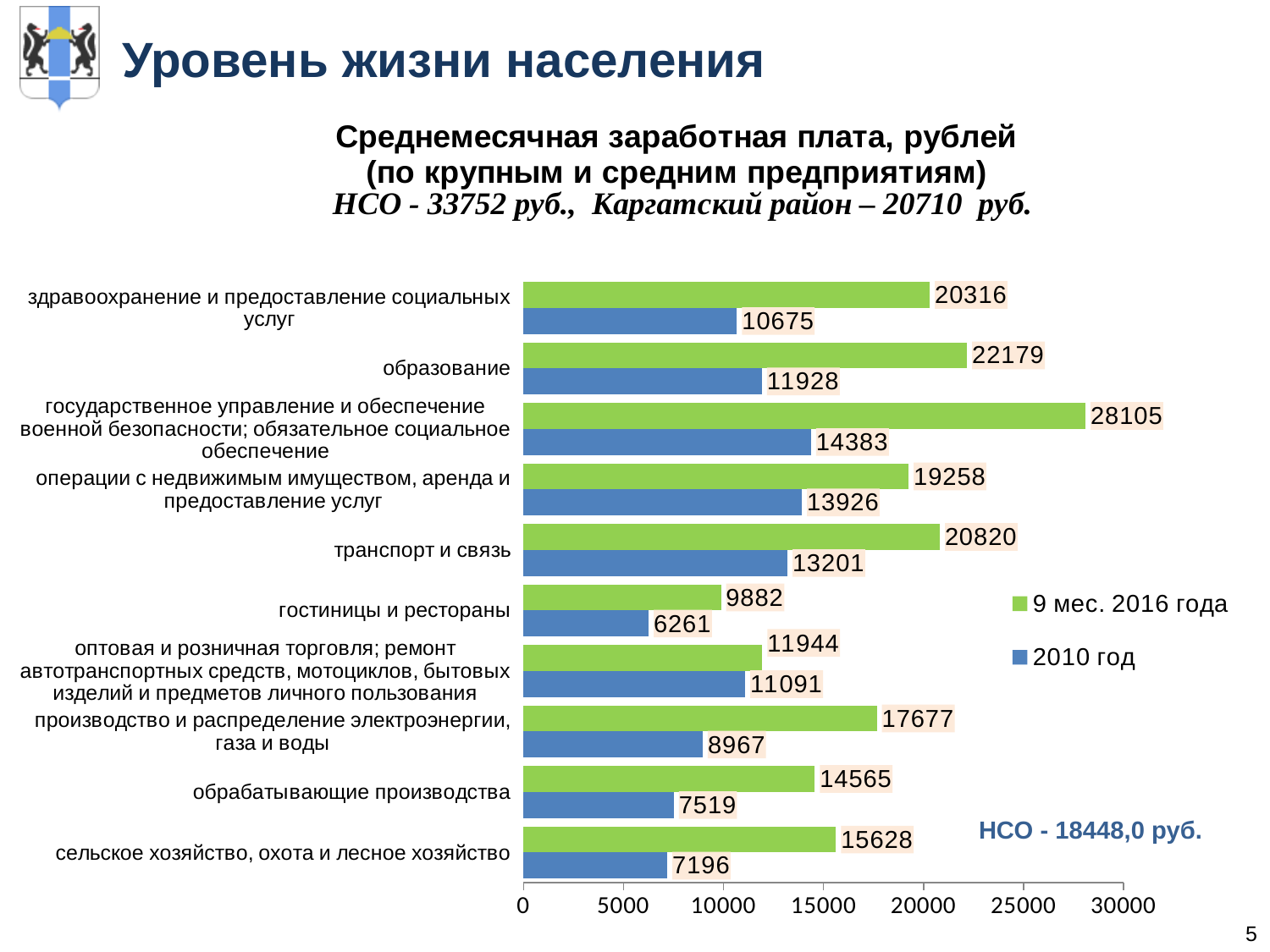
Which category has the lowest value in the '2010 год' series? гостиницы и рестораны How many series does the legend list? 2 What type of chart is shown on the slide? bar chart Is the '9 мес. 2016 года' value for 'обрабатывающие производства' greater or less than 15000? less What is the difference between the '9 мес. 2016 года' and '2010 год' values for 'сельское хозяйство, охота и лесное хозяйство'? 8432 What is the value for 'транспорт и связь' in the '2010 год' series? 13201 What is the title of the chart? Среднемесячная заработная плата, рублей (по крупным и средним предприятиям) What is the difference between the '9 мес. 2016 года' and '2010 год' values for 'образование'? 10251 Which is larger in the '9 мес. 2016 года' series: 'транспорт и связь' or 'операции с недвижимым имуществом, аренда и предоставление услуг'? транспорт и связь What is the value for 'образование' in the '9 мес. 2016 года' series? 22179 Which category has the highest value in the '9 мес. 2016 года' series? государственное управление и обеспечение военной безопасности; обязательное социальное обеспечение How many categories (industries) are shown in the chart? 10